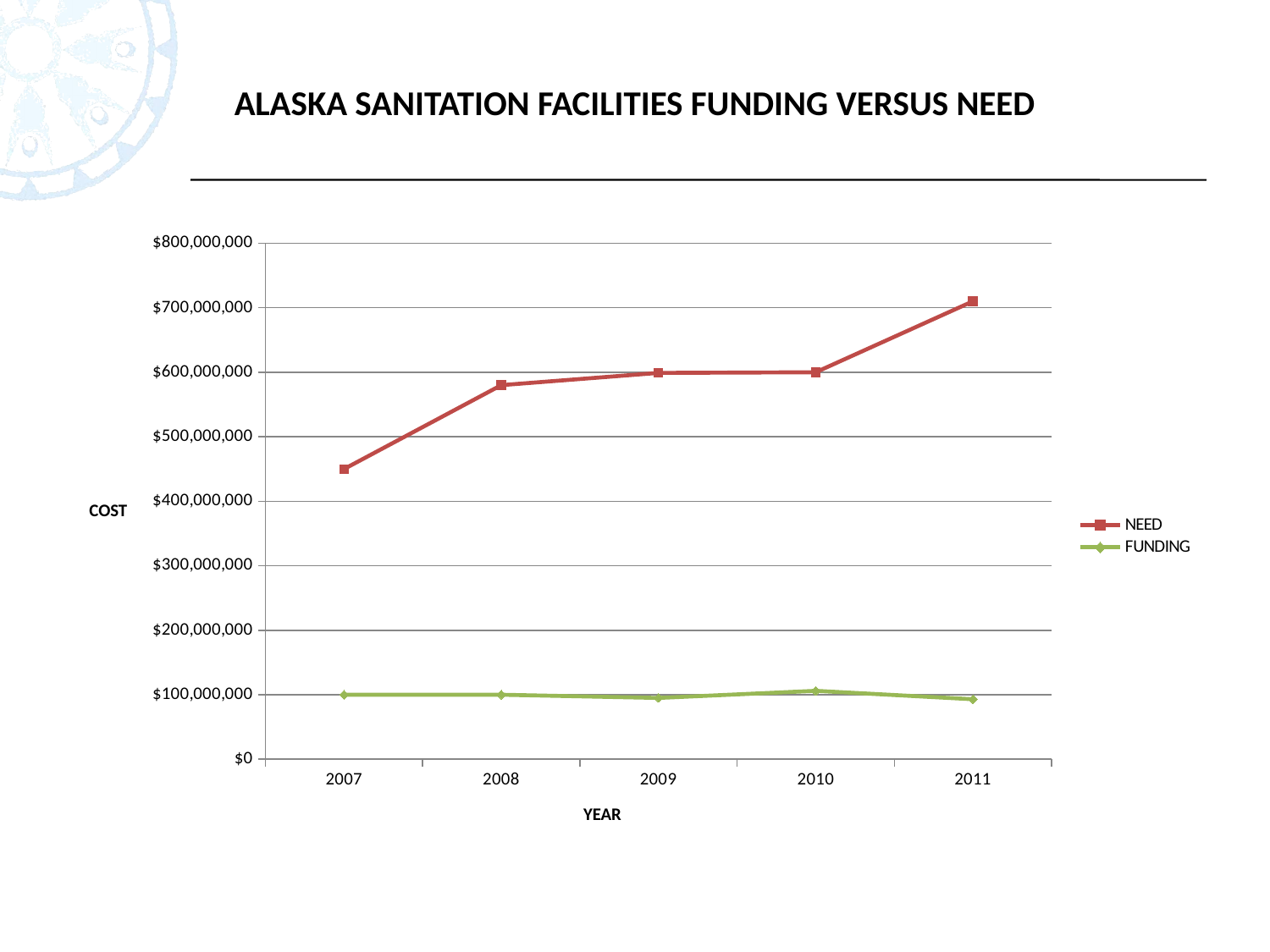
How many years are plotted along the x axis? 5 Which series has the larger value in 2010, NEED or FUNDING? NEED Is the FUNDING value for 2009 greater or less than $200,000,000? less How many series does the legend list? 2 In which year is the NEED value lowest? 2007 What is the title of the chart? ALASKA SANITATION FACILITIES FUNDING VERSUS NEED Is the NEED value for 2007 greater or less than $500,000,000? less What kind of chart is shown on the slide? line chart Is the NEED value for 2008 greater or less than $500,000,000? greater In which year is the NEED value highest? 2011 Does the NEED line generally rise or fall from 2007 to 2011? rise